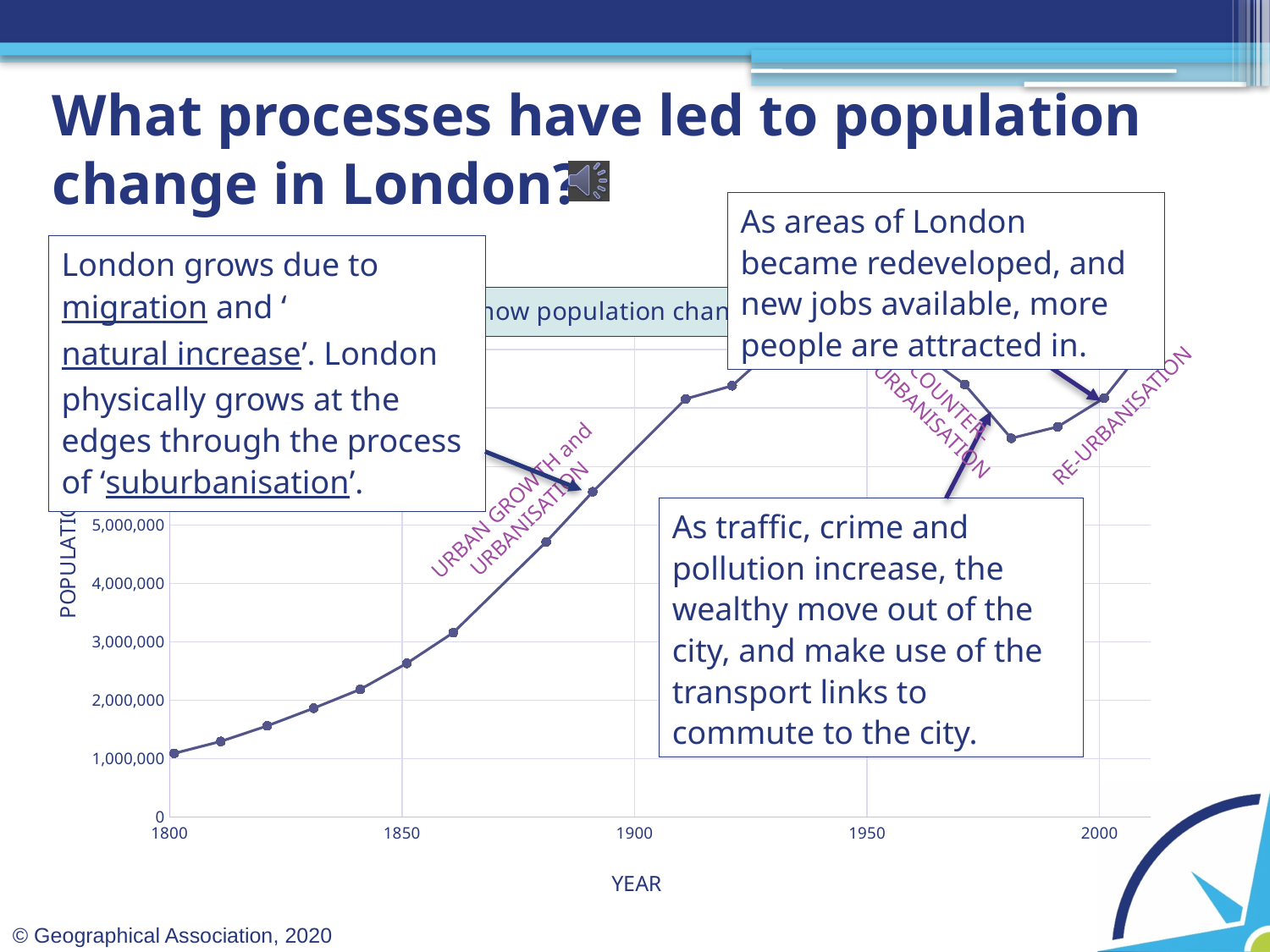
Which year has the larger population value, 1850 or 1900? 1900 Is the population value for 1880 greater or less than 4,000,000? greater Does the population rise or fall between 1980 and 2000? Rises Is the population value for 1820 greater or less than 2,000,000? less Which year has the larger population value, 1800 or 1850? 1850 Which year shown on the chart has the lowest population value? 1800 Does the population rise or fall between 1800 and 1900? Rises Is the population value for 1840 greater or less than 3,000,000? less What kind of chart is shown on the slide? Line chart What is the label on the x axis of the chart? YEAR